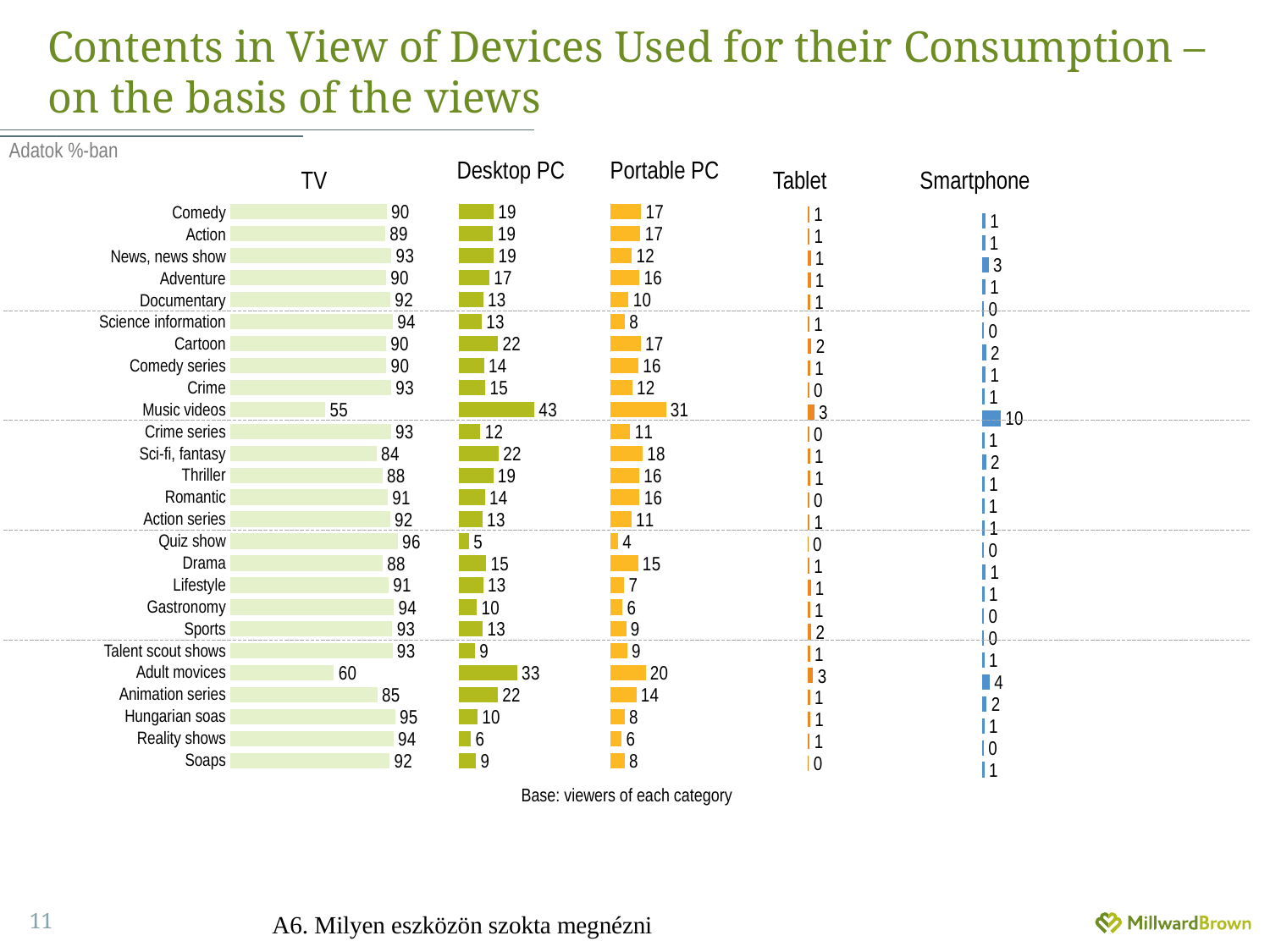
In the Smartphone chart, what is the value for Music videos? 10 In the Portable PC chart, what is the value for Sci-fi, fantasy? 18 What kind of chart is the Tablet chart? Bar chart How many categories are shown in the TV chart? 26 In the Desktop PC chart, which category has the lowest value? Quiz show In the Desktop PC chart, what is the value for Adult movices? 33 In the Desktop PC chart, which is larger, the value for Cartoon or the value for Crime? Cartoon In the TV chart, which category has the highest value? Quiz show In the TV chart, what is the value for Music videos? 55 In the Tablet chart, what is the value for Adult movices? 3 In the Portable PC chart, which category has the highest value? Music videos In the TV chart, what is the difference between the values for Quiz show and Music videos? 41